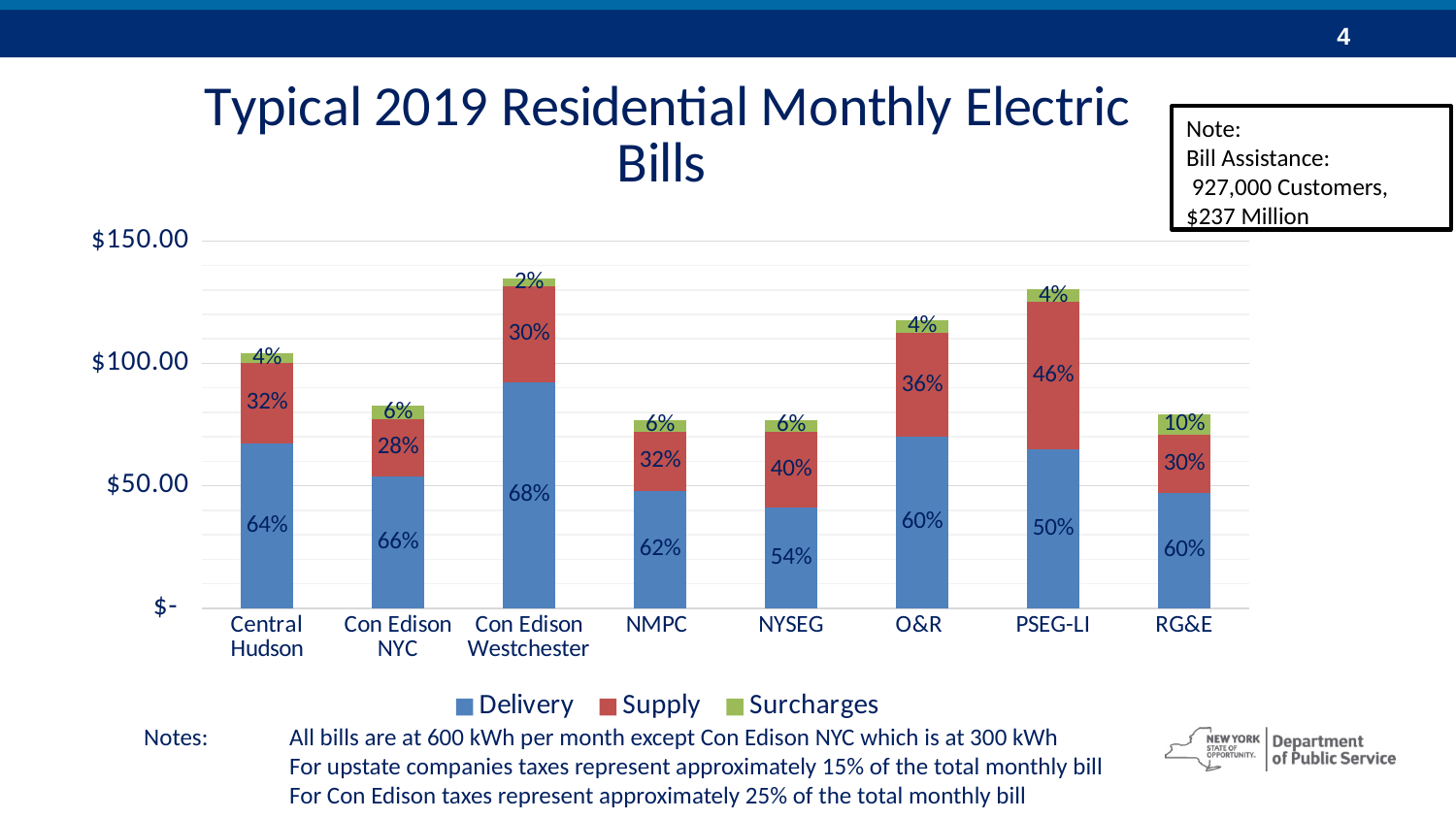
What kind of chart is shown on the slide? Stacked bar chart What percentage of the NYSEG bill is Delivery? 54% How many series does the chart legend list? 3 Which company has the lowest Surcharges percentage label? Con Edison Westchester Which company has the highest Surcharges percentage label? RG&E What percentage of the PSEG-LI bill is Supply? 46% What percentage of the RG&E bill is Surcharges? 10% What are the three series listed in the chart legend? Delivery, Supply, Surcharges Is the total monthly bill for NMPC greater or less than $100.00? less Is the total monthly bill for PSEG-LI greater or less than $100.00? greater Which company has the tallest total bar (highest typical monthly bill)? Con Edison Westchester How many utility companies are shown on the x axis of the chart? 8